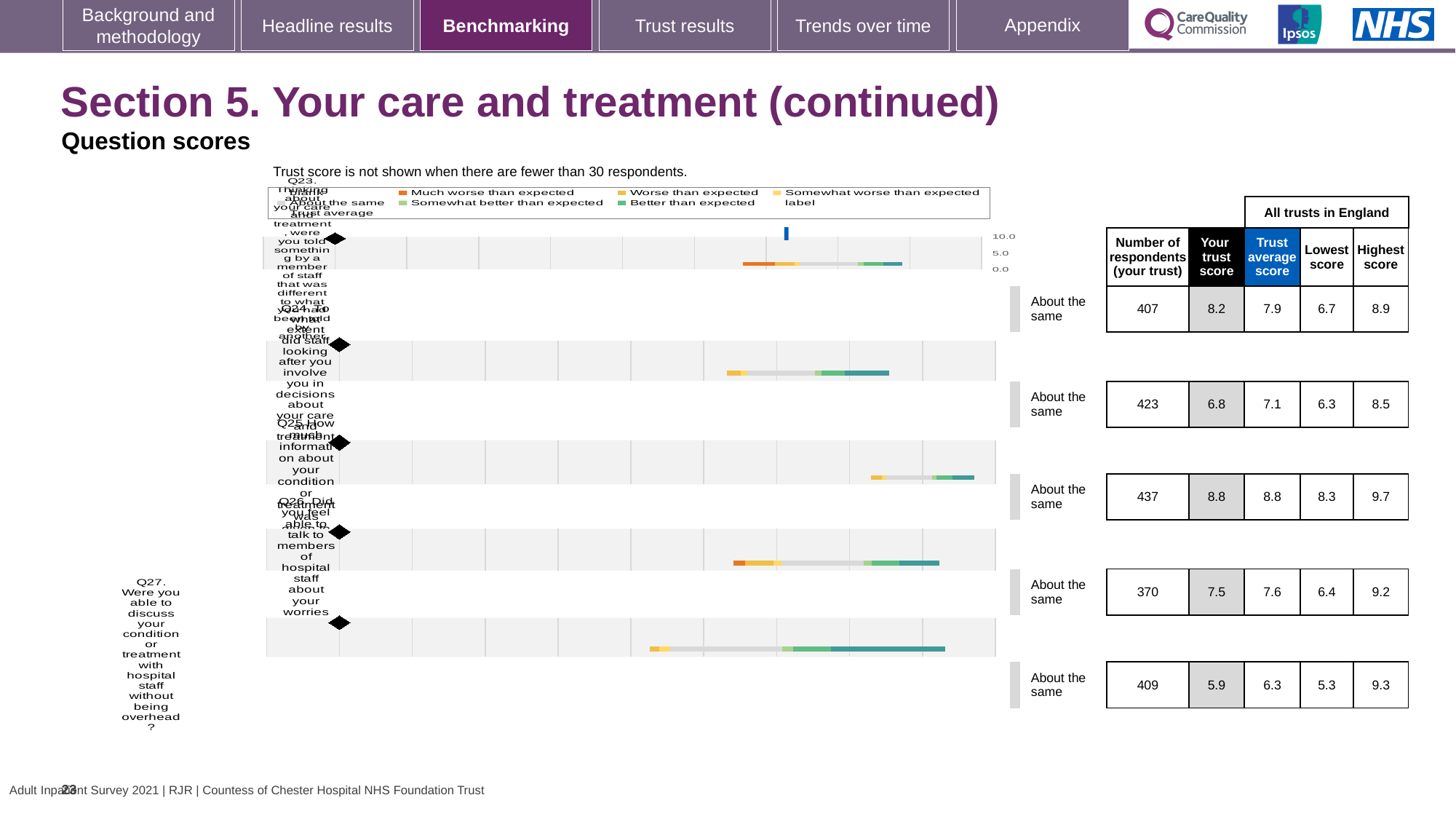
What is the difference between the trust score and the trust average score for Q27? 0.4 What kind of chart is used to show the question scores? Bar chart Which question has the lowest trust score? Q27 How many questions are shown on the chart? 5 What is the lowest score across all trusts in England for Q24? 6.3 Which question has the highest trust score? Q25 Is the trust score for Q23 higher or lower than the trust average score for Q23? higher What benchmark category is shown for Q26? About the same What is the trust score for Q27 (discussing your condition or treatment without being overheard)? 5.9 What is the highest score across all trusts in England for Q26? 9.2 What is the trust average score for Q24? 7.1 How many respondents answered Q25 at this trust? 437